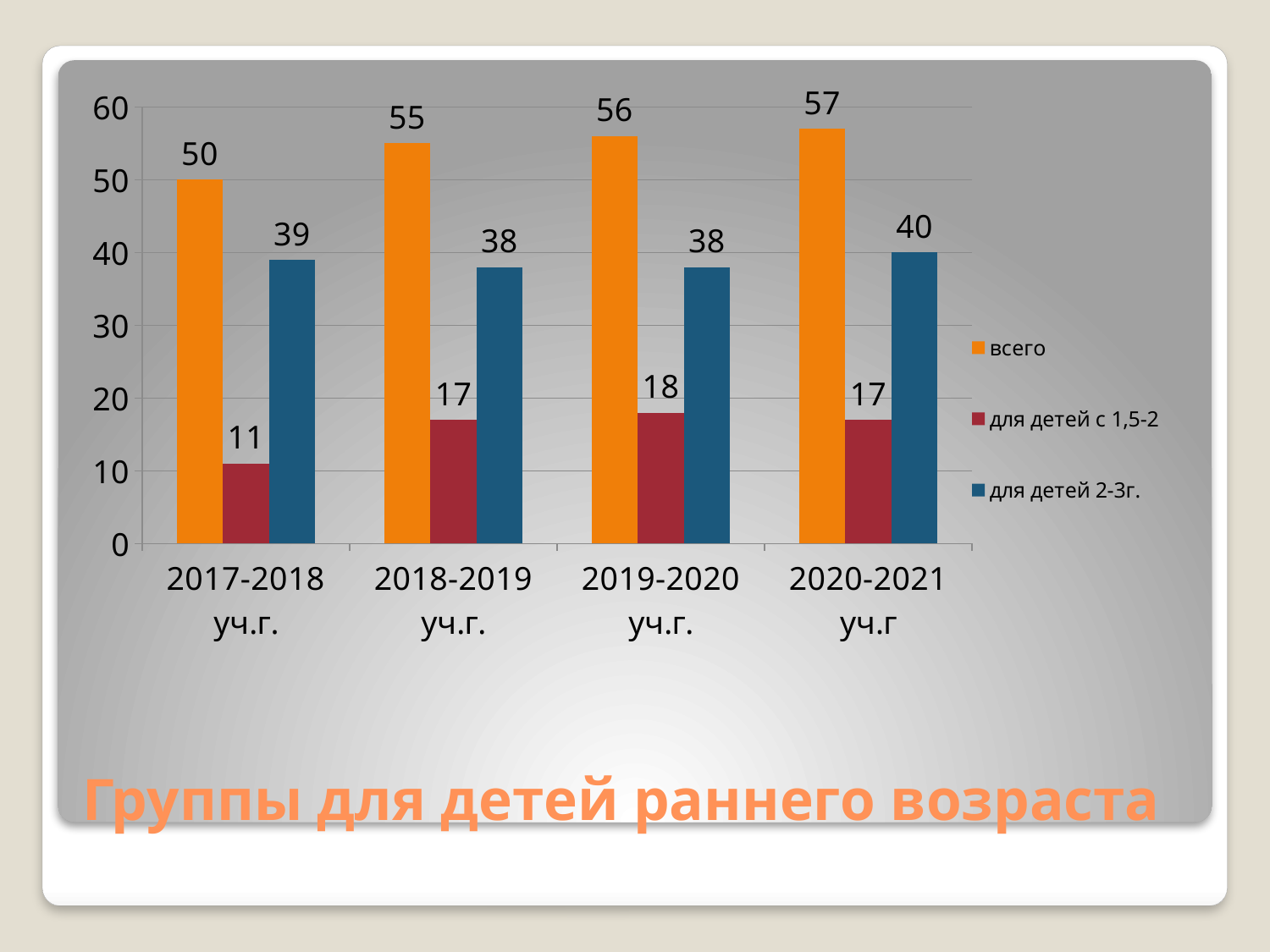
What is the title of the slide? Группы для детей раннего возраста What is the value of 'для детей с 1,5-2' for 2019-2020 уч.г.? 18 What is the value of 'для детей 2-3г.' for 2020-2021 уч.г? 40 What is the difference between 'всего' in 2020-2021 уч.г and 'всего' in 2017-2018 уч.г.? 7 What is the value of 'всего' for 2017-2018 уч.г.? 50 What kind of chart is shown on the slide? bar chart How many years (categories) are shown on the x axis? 4 Does the 'всего' series rise or fall from 2017-2018 уч.г. to 2020-2021 уч.г? rise In which year is the 'всего' value highest? 2020-2021 уч.г Which is larger: 'для детей 2-3г.' in 2017-2018 уч.г. or 'для детей 2-3г.' in 2018-2019 уч.г.? 2017-2018 уч.г. How many series does the legend list? 3 In which year is the 'для детей с 1,5-2' value lowest? 2017-2018 уч.г.